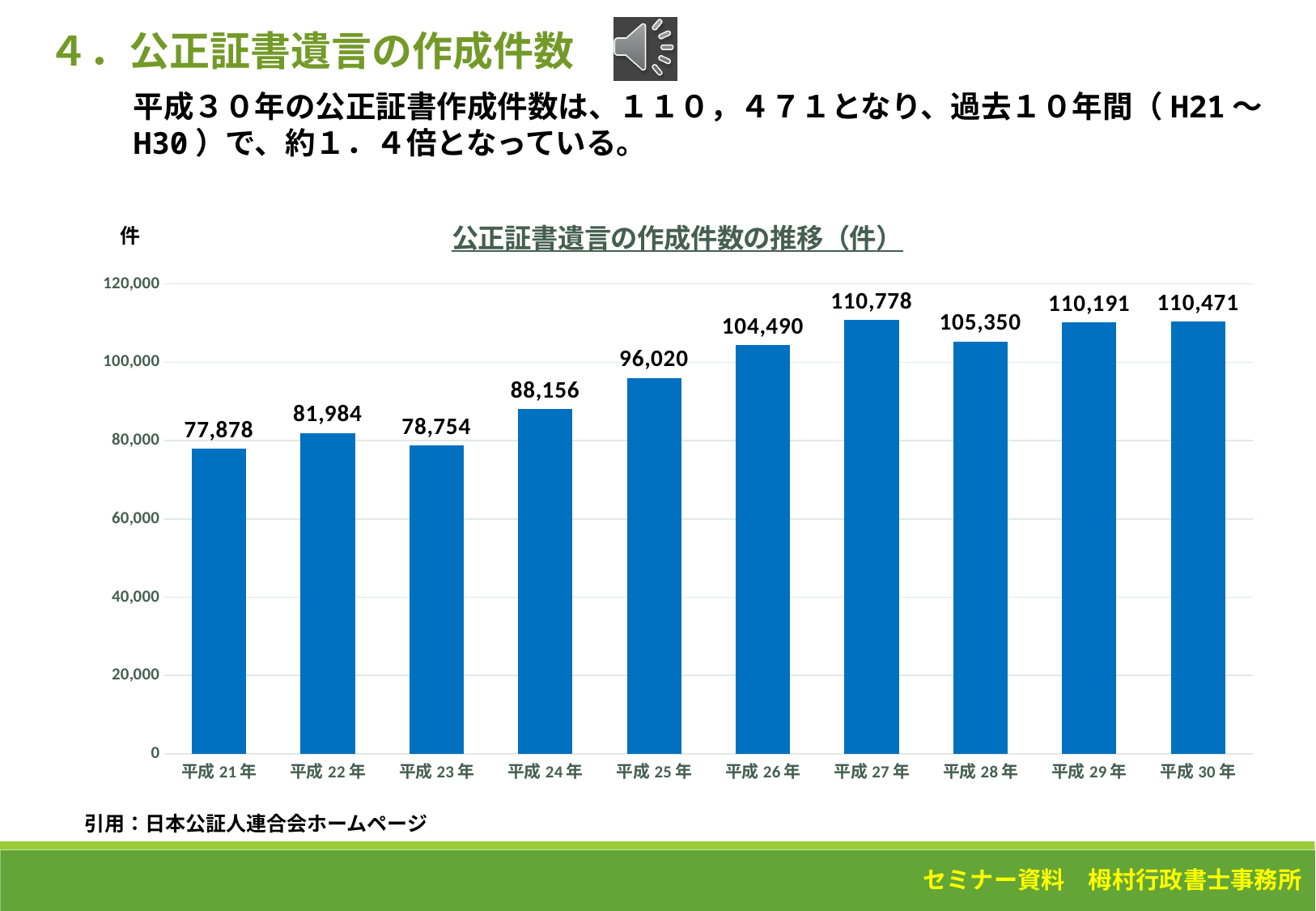
Which year has the lowest value? 平成21年 Is the value for 平成25年 greater or less than 100,000? less What is the title of the chart? 公正証書遺言の作成件数の推移（件） What is the difference between the values for 平成30年 and 平成21年? 32,593 What kind of chart is shown on the slide? bar chart What is the value for 平成26年? 104,490 How many years are shown on the x axis? 10 Which is larger, the value for 平成23年 or 平成24年? 平成24年 Which year has the highest value? 平成27年 What is the value for 平成24年? 88,156 What is the difference between the values for 平成27年 and 平成28年? 5,428 What is the value for 平成30年? 110,471